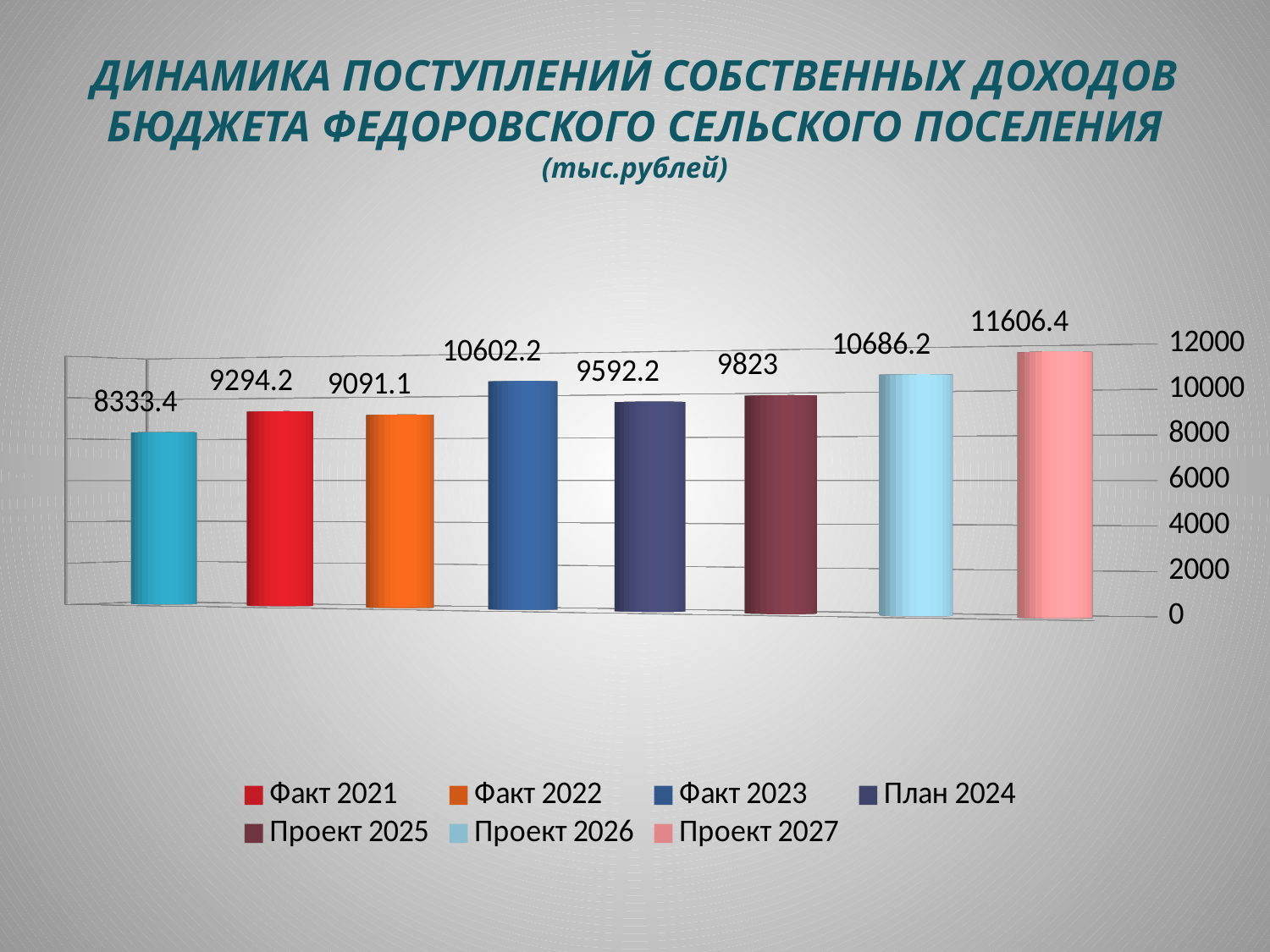
How many bars are plotted on the chart? 8 What is the difference between Проект 2027 and Факт 2023? 1004.2 What kind of chart is shown on the slide? Bar chart What is the difference between Факт 2021 and Факт 2022? 203.1 What is the value for Факт 2021? 9294.2 How many entries does the legend list? 7 What is the value for Факт 2023? 10602.2 What is the value for План 2024? 9592.2 What is the value for Проект 2026? 10686.2 Which is larger, Факт 2023 or План 2024? Факт 2023 What is the lowest value shown on the chart? 8333.4 Which legend entry has the highest value? Проект 2027